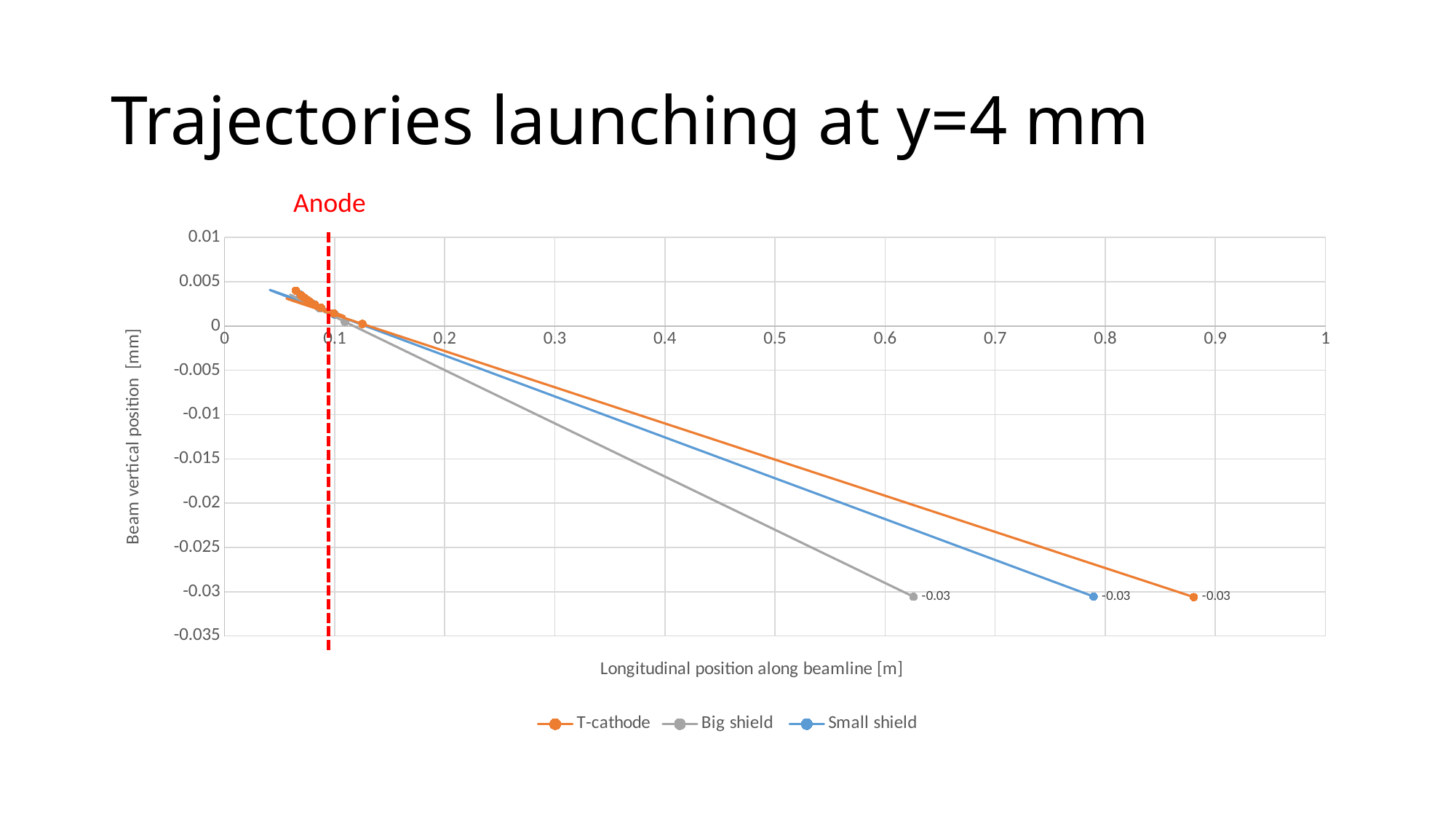
What is the labelled final value of the Big shield series? -0.03 What is the title of the x axis? Longitudinal position along beamline [m] What is the labelled final value of the T-cathode series? -0.03 Is the longitudinal position where the Small shield series ends greater or less than 0.7? greater Which series reaches -0.03 at the largest longitudinal position? T-cathode Is the longitudinal position where the Big shield series ends greater or less than 0.7? less What is the labelled final value of the Small shield series? -0.03 Do the beam vertical position values rise or fall as the longitudinal position increases? fall What does the red dashed vertical line represent? Anode What kind of chart is shown on the slide? line chart Which series reaches -0.03 at the smallest longitudinal position? Big shield How many series does the legend list? 3